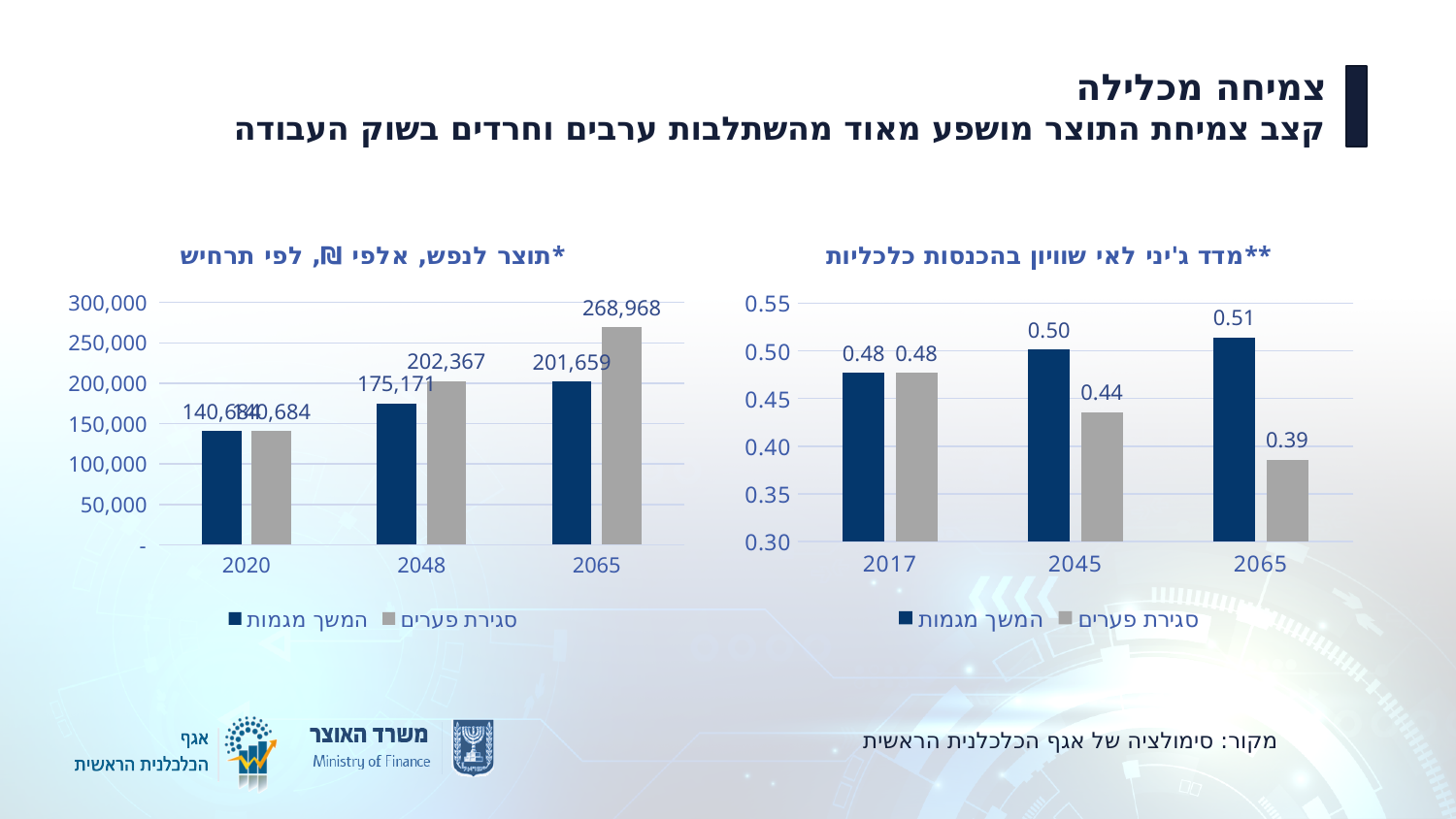
What kind of chart is the Gini index chart (right)? bar chart In the Gini index chart (right), do the values for סגירת פערים rise or fall from 2017 to 2065? fall In the GDP per capita chart (left), which year has the highest value for סגירת פערים? 2065 In the GDP per capita chart (left), what is the value for המשך מגמות in 2048? 175,171 In the GDP per capita chart (left), what is the difference between סגירת פערים and המשך מגמות in 2065? 67,309 In the GDP per capita chart (left), what is the value for סגירת פערים in 2065? 268,968 In the Gini index chart (right), what is the value for סגירת פערים in 2065? 0.39 In the Gini index chart (right), what is the value for המשך מגמות in 2045? 0.50 How many years are shown on the x axis of the GDP per capita chart (left)? 3 In the Gini index chart (right), which year has the lowest value for סגירת פערים? 2065 In the Gini index chart (right), what is the difference between המשך מגמות and סגירת פערים in 2065? 0.12 In the Gini index chart (right), which series has the larger value in 2045, המשך מגמות or סגירת פערים? המשך מגמות